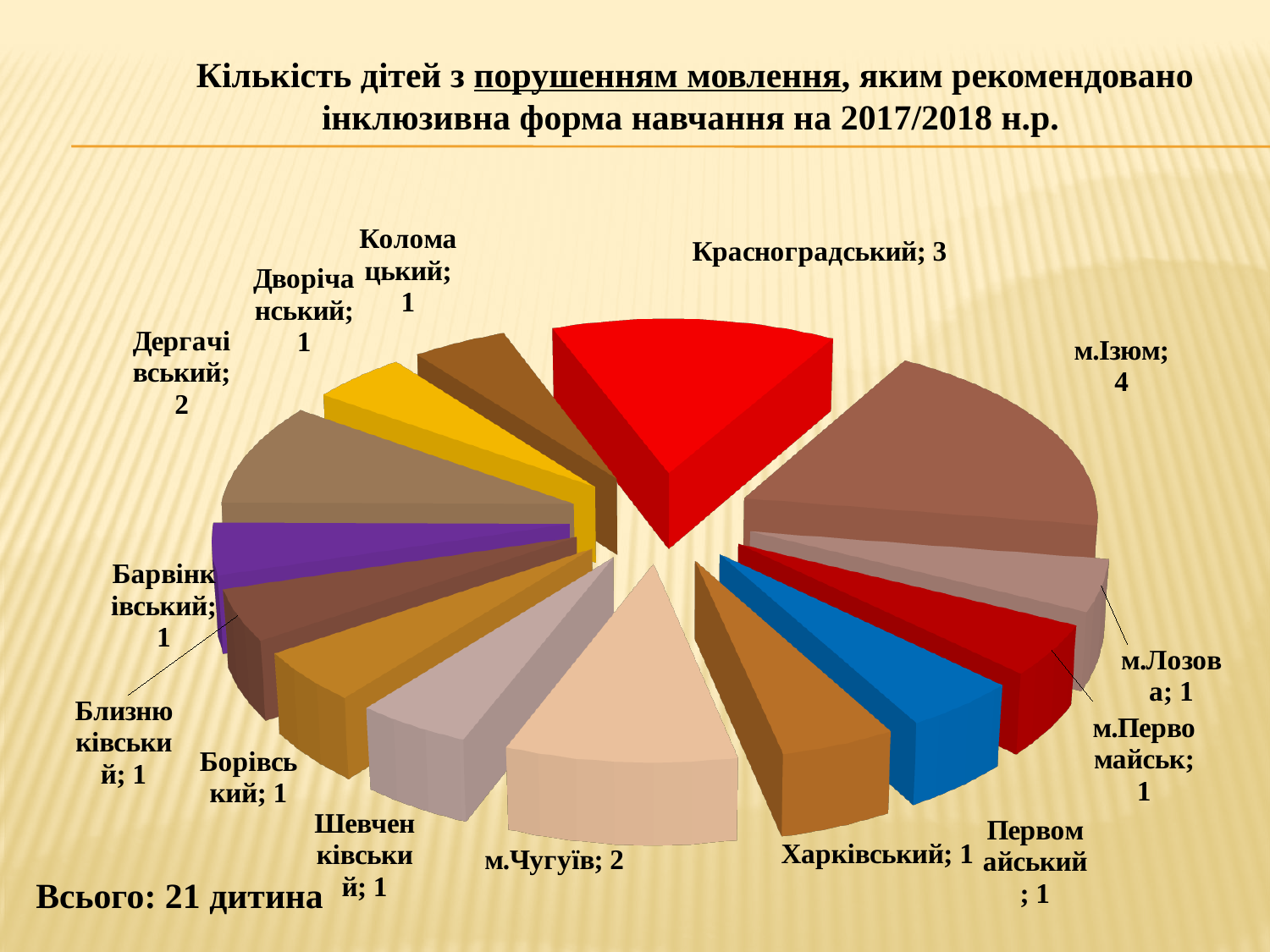
What kind of chart is shown on the slide? pie chart What is the value for Дергачівський? 2 What is the difference between the values for м.Ізюм and Красноградський? 1 What is the value for м.Чугуїв? 2 How many categories (slices) does the pie chart have? 14 What is the value for Красноградський? 3 What school year does the chart title refer to? 2017/2018 н.р. What is the total number of children shown on the slide? 21 Which category has the largest slice of the pie? м.Ізюм How many children are shown for м.Ізюм? 4 What is the value for Харківський? 1 Which is larger, the value for Красноградський or the value for м.Чугуїв? Красноградський